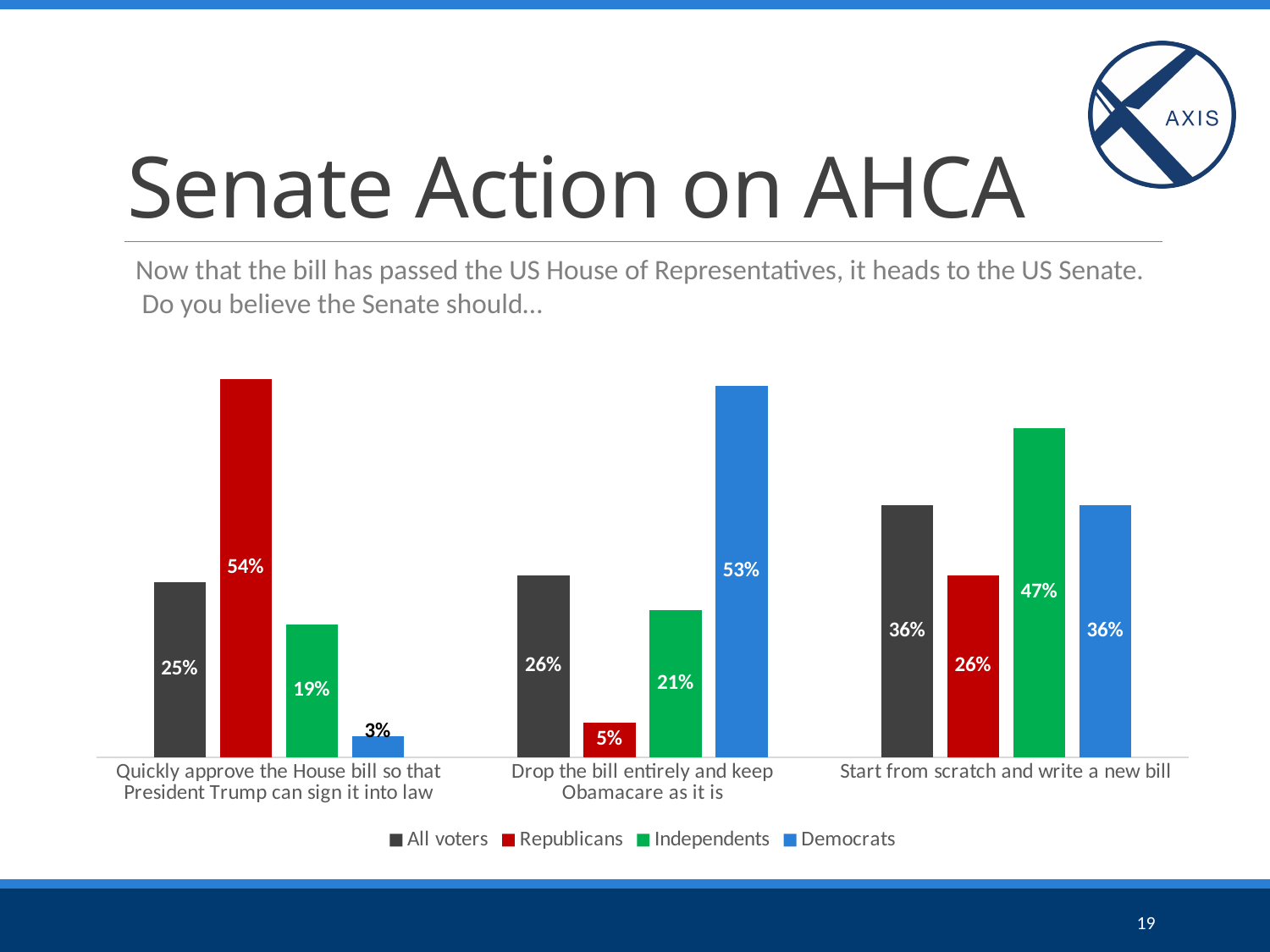
What percentage of Independents say the Senate should start from scratch and write a new bill? 47% What percentage of Republicans say the Senate should quickly approve the House bill so that President Trump can sign it into law? 54% What is the difference between the Republicans and Democrats values for 'Quickly approve the House bill so that President Trump can sign it into law'? 51% What colour represents Republicans in the chart? Red Which group has the lowest value for 'Quickly approve the House bill so that President Trump can sign it into law'? Democrats How many series does the legend list? 4 Which is larger for 'Start from scratch and write a new bill': the Independents value or the Republicans value? Independents What is the All voters value for 'Drop the bill entirely and keep Obamacare as it is'? 26% What percentage of Democrats say the Senate should drop the bill entirely and keep Obamacare as it is? 53% What kind of chart is shown on the slide? Bar chart How many response options (categories) are shown on the x axis? 3 Which group has the highest value for 'Drop the bill entirely and keep Obamacare as it is'? Democrats